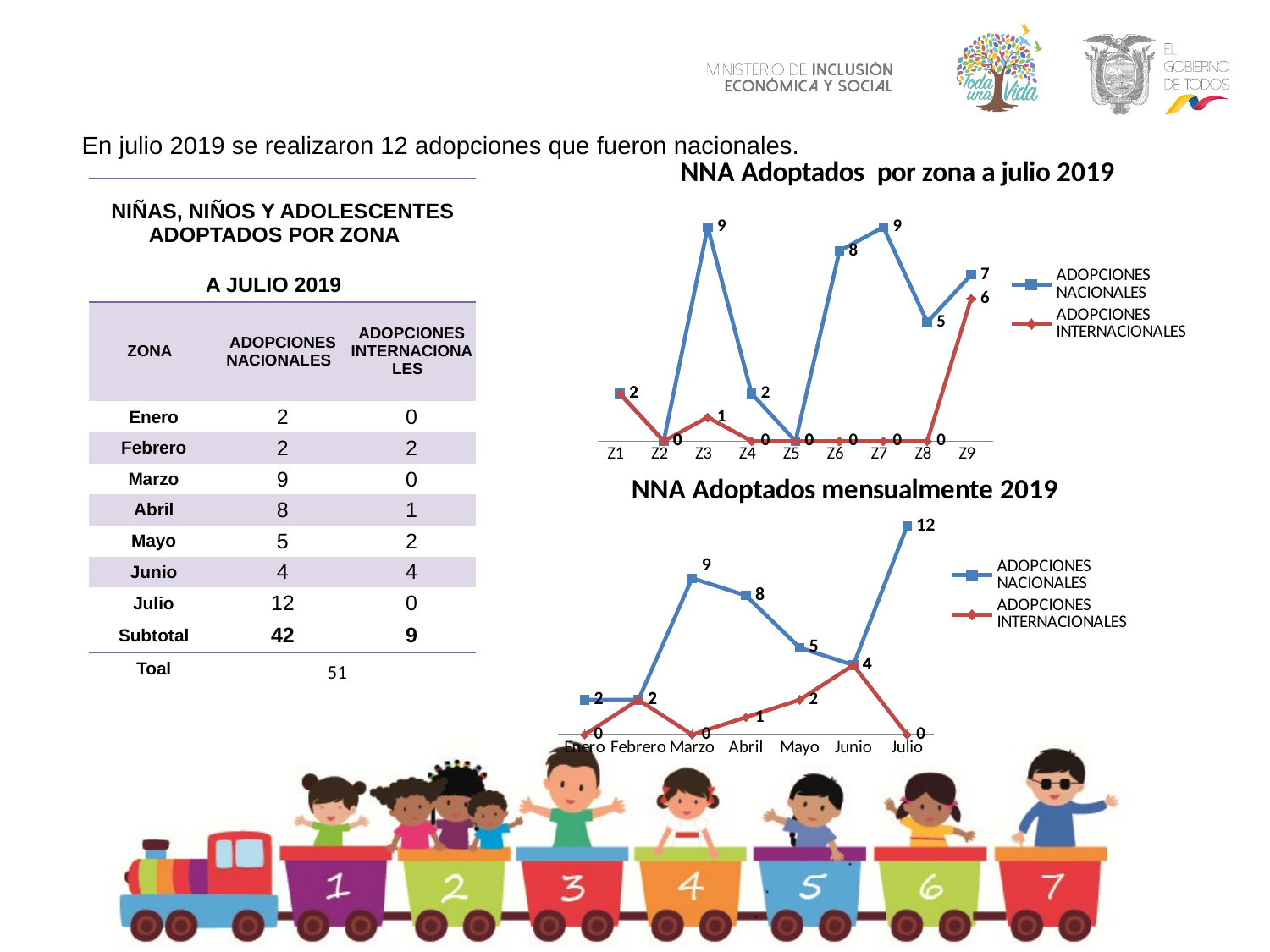
In the 'NNA Adoptados por zona a julio 2019' chart, what is the value of ADOPCIONES NACIONALES for Z6? 8 In the 'NNA Adoptados mensualmente 2019' chart, how many months are shown on the x axis? 7 In the 'NNA Adoptados por zona a julio 2019' chart, what is the difference between ADOPCIONES NACIONALES and ADOPCIONES INTERNACIONALES for Z8? 5 In the 'NNA Adoptados por zona a julio 2019' chart, how many series does the legend list? 2 In the 'NNA Adoptados por zona a julio 2019' chart, what is the value of ADOPCIONES INTERNACIONALES for Z9? 6 In the 'NNA Adoptados mensualmente 2019' chart, which month has the highest value for ADOPCIONES INTERNACIONALES? Junio In the 'NNA Adoptados mensualmente 2019' chart, what is the difference between ADOPCIONES NACIONALES in Marzo and in Abril? 1 In the 'NNA Adoptados mensualmente 2019' chart, what is the value of ADOPCIONES NACIONALES for Julio? 12 In the 'NNA Adoptados por zona a julio 2019' chart, which zone has the highest value for ADOPCIONES INTERNACIONALES? Z9 What kind of chart is 'NNA Adoptados mensualmente 2019'? Line chart In the 'NNA Adoptados por zona a julio 2019' chart, how many zones are shown on the x axis? 9 In the 'NNA Adoptados mensualmente 2019' chart, which is larger in Mayo: ADOPCIONES NACIONALES or ADOPCIONES INTERNACIONALES? ADOPCIONES NACIONALES